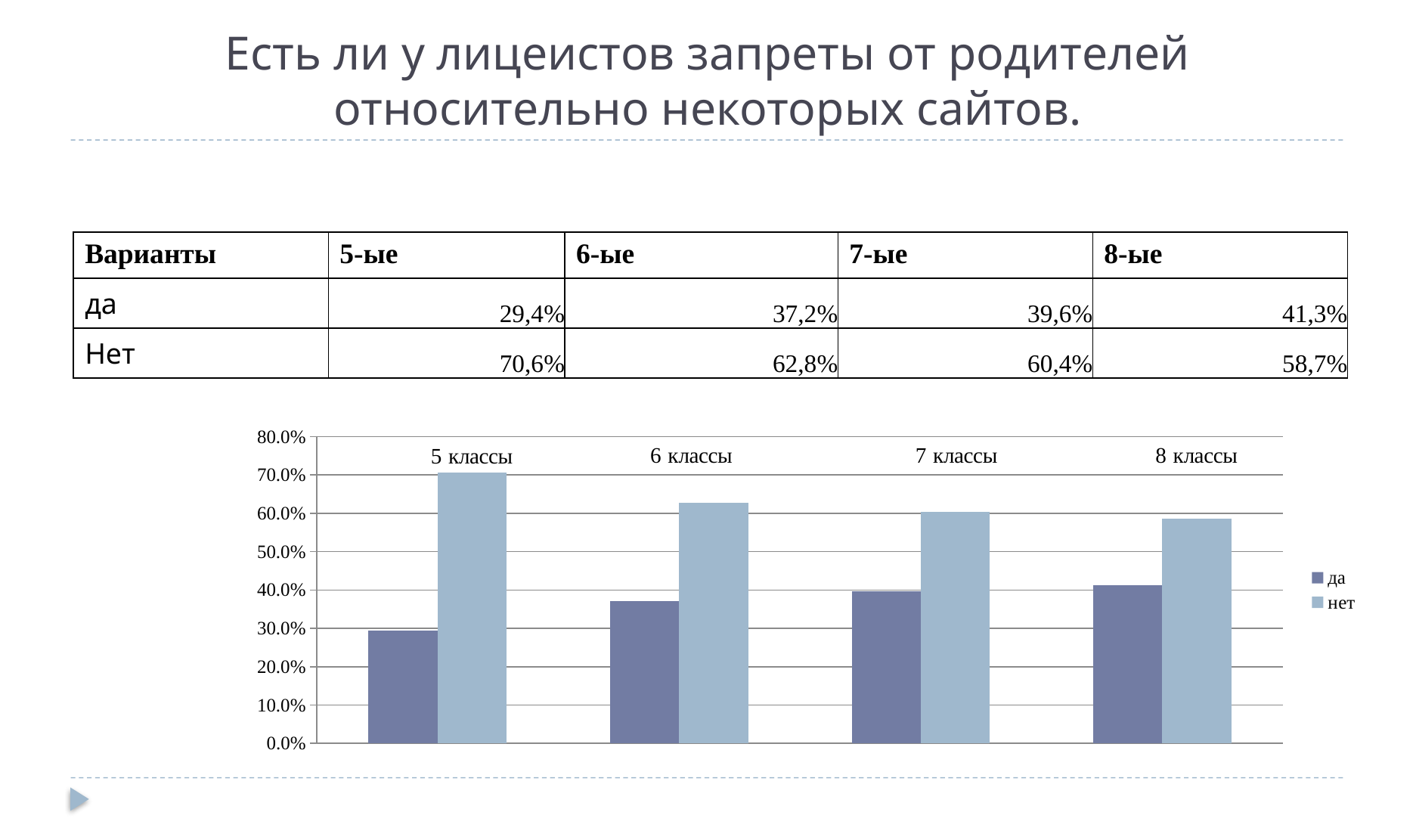
Which class group has the lowest "да" value? 5 классы What is the difference between the "нет" and "да" values for the 6th classes? 25,6% According to the slide, what is the value of "нет" for the 8th classes? 58,7% Do the "да" values rise or fall from the 5th classes to the 8th classes? rise How many series does the chart legend list? 2 Which class group has the highest "нет" value? 5 классы According to the slide, what is the value of "да" for the 7th classes? 39,6% According to the slide, what is the value of "да" for the 5th classes? 29,4% How many class groups (categories) are shown on the x axis of the chart? 4 Which is larger for the 8th classes: the "да" value or the "нет" value? нет What kind of chart is shown on the slide? bar chart Is the "да" value for the 8th classes greater or less than 40.0%? greater